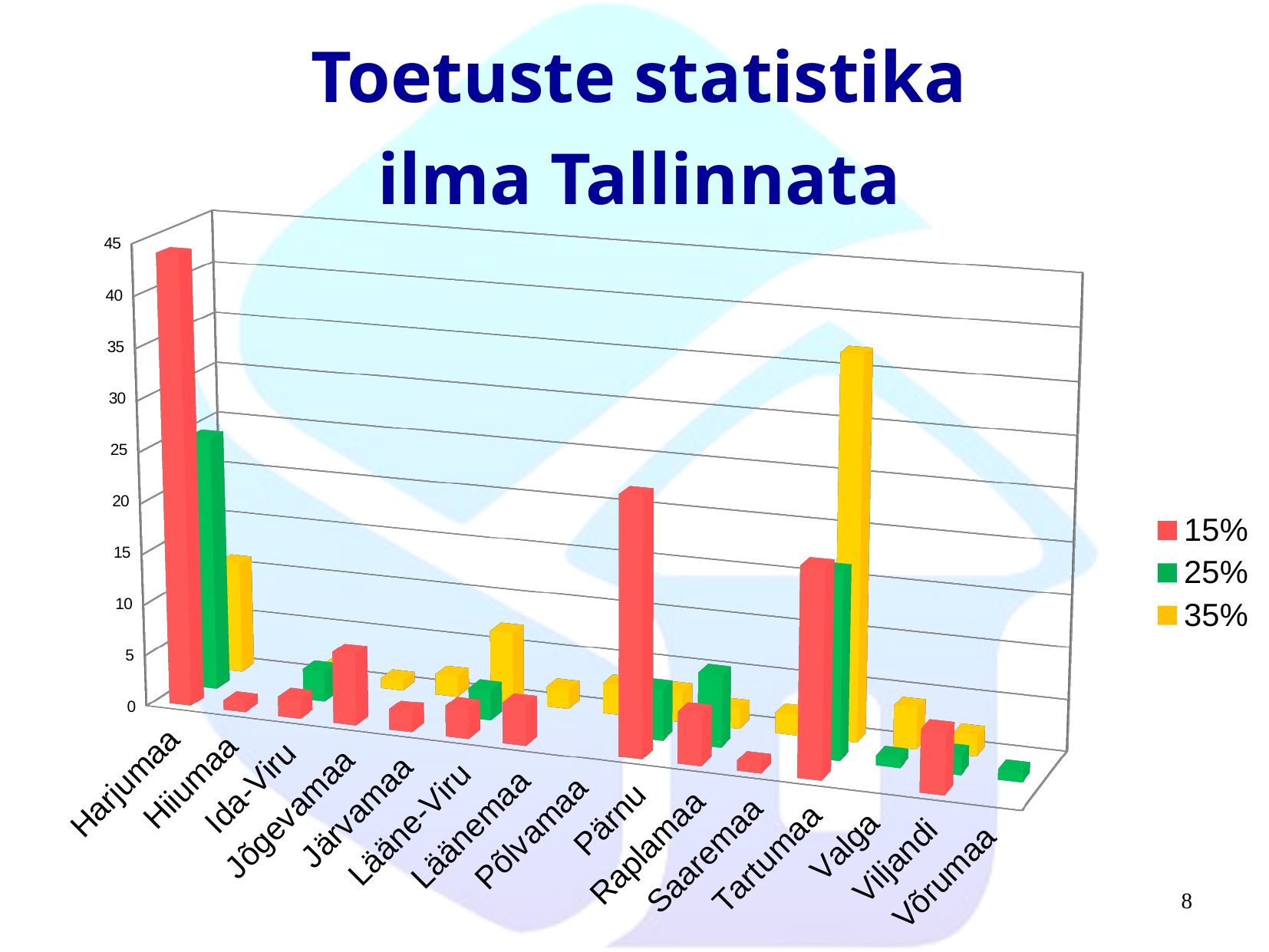
Is the value for Pärnu in the 15% series greater or less than 15? greater Which category has the highest value for the 15% series? Harjumaa Is the value for Harjumaa in the 25% series greater or less than 20? greater What kind of chart is shown on the slide? bar chart Is the value for Tartumaa in the 35% series greater or less than 30? greater What colour represents the 35% series in the chart? yellow Which category has the highest value for the 35% series? Tartumaa How many categories are shown along the x axis of the chart? 15 How many series does the chart's legend list? 3 Which is larger in the 15% series: Harjumaa or Pärnu? Harjumaa Which is larger in the 35% series: Tartumaa or Harjumaa? Tartumaa